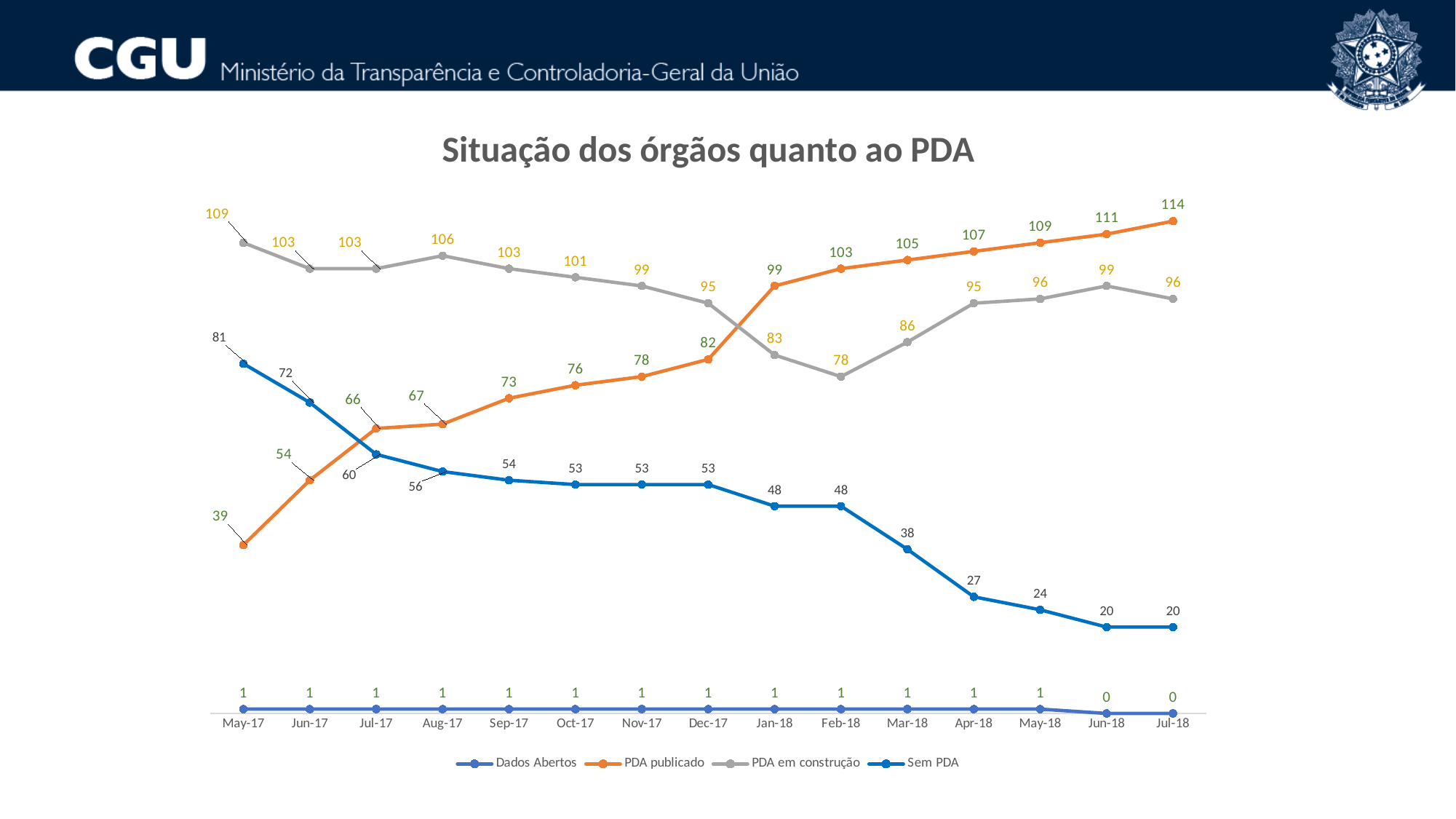
How many months are shown on the x axis? 15 What is the value of PDA publicado in Jul-18? 114 Which is larger in Dec-17: PDA publicado or PDA em construção? PDA em construção What is the title of the chart? Situação dos órgãos quanto ao PDA In which month does PDA publicado reach its lowest value? May-17 What is the value of PDA em construção in Feb-18? 78 How many series does the legend list? 4 In which month does PDA em construção reach its highest value? May-17 What is the value of Sem PDA in May-17? 81 What is the difference between PDA publicado and Sem PDA in Jul-18? 94 What kind of chart is shown on the slide? Line chart Does the Sem PDA series rise or fall from May-17 to Jul-18? Fall